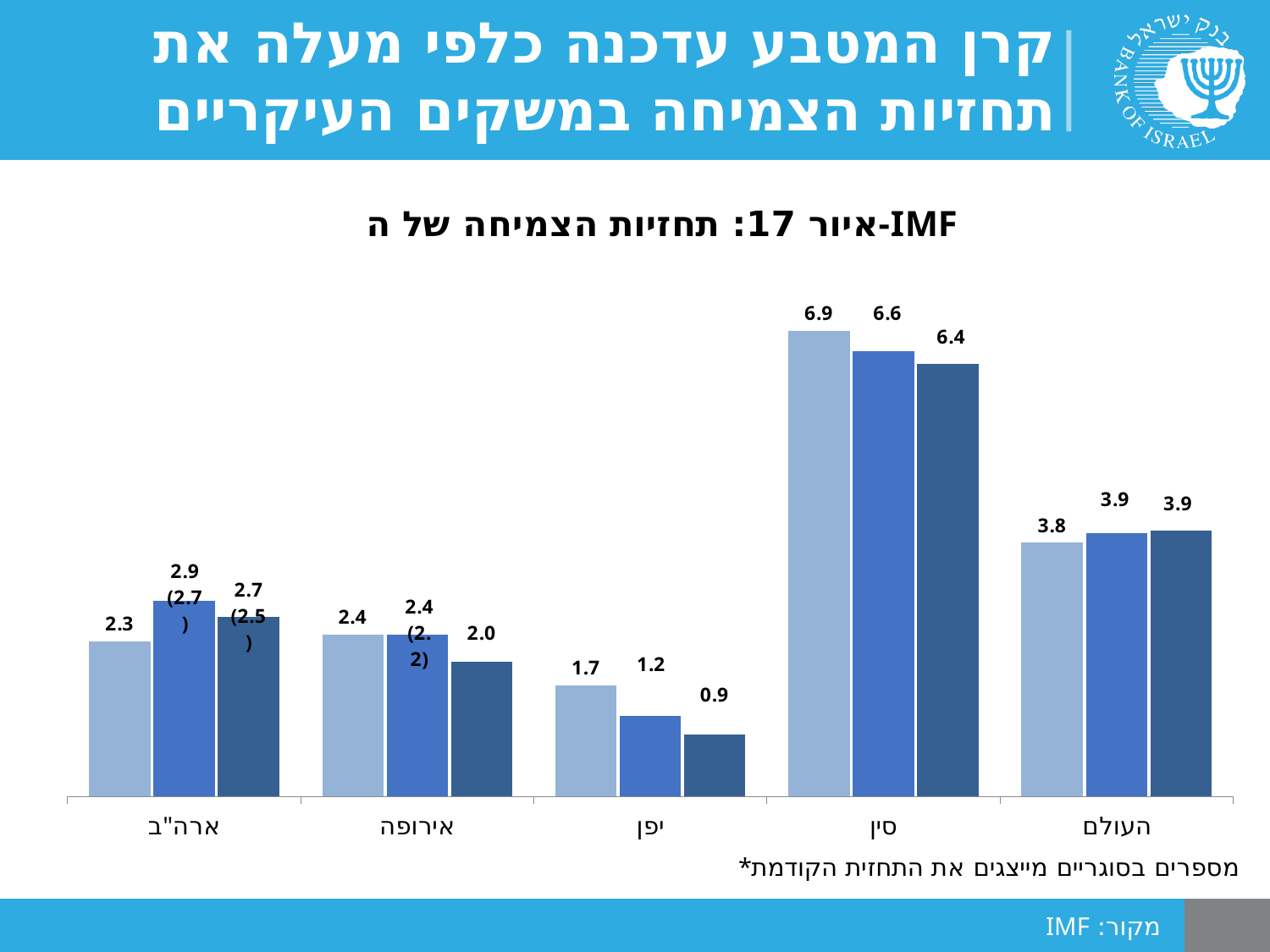
Which is larger: the middle bar for ארה"ב (USA) or the middle bar for אירופה (Europe)? ארה"ב What is the value of the leftmost (light blue) bar for העולם (World)? 3.8 Which category has the lowest values in the chart? יפן What is the value of the middle bar for ארה"ב (USA)? 2.9 What is the value of the leftmost (light blue) bar for סין (China)? 6.9 Which category has the highest values in the chart? סין How many categories are shown on the x axis? 5 Do the three bars for יפן (Japan) rise or fall from left to right? fall What kind of chart is shown on the slide? bar chart What is the value of the rightmost (dark blue) bar for יפן (Japan)? 0.9 What is the title of the chart? איור 17: תחזיות הצמיחה של ה-IMF What is the difference between the leftmost bar (6.9) and the rightmost bar (6.4) for סין (China)? 0.5